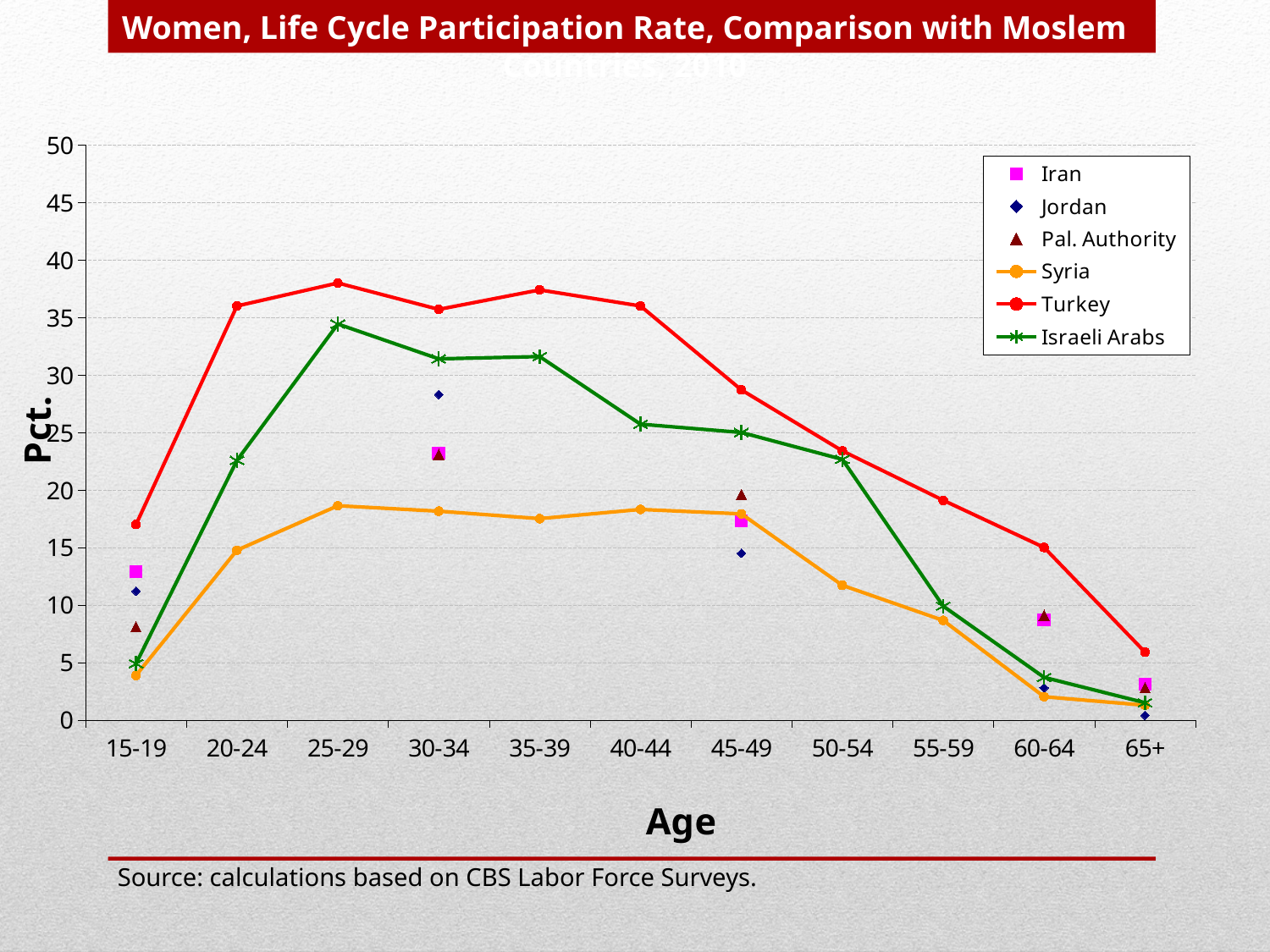
For which age group is the Israeli Arabs value highest? 25-29 Is the value for Syria at age 55-59 greater or less than 10? less How many series does the legend list? 6 What kind of chart is shown on the slide? line chart Is the value for Turkey at age 25-29 greater or less than 35? greater Is the value for Israeli Arabs at age 15-19 greater or less than 10? less Does the Turkey line rise or fall from age 45-49 to 65+? fall What is the label of the x axis? Age At age 30-34, which is larger, the value for Turkey or for Israeli Arabs? Turkey How many age groups are shown on the x axis? 11 For which age group is the Turkey value lowest? 65+